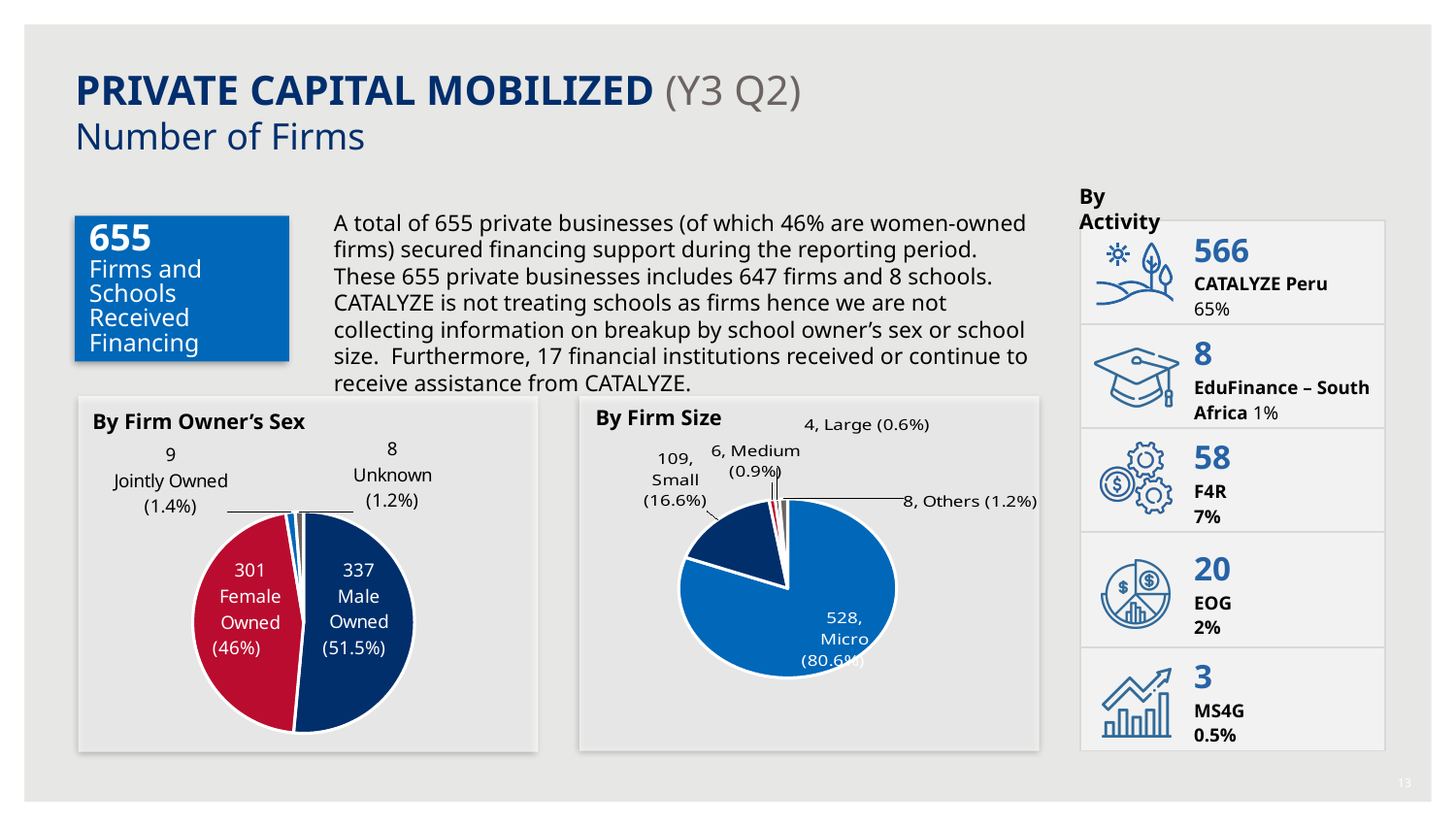
In the 'By Firm Owner's Sex' chart, which category has the smallest number of firms? Unknown In the 'By Firm Owner's Sex' chart, how many firms are Male Owned? 337 In the 'By Firm Size' chart, what is the difference between the number of Micro and Small firms? 419 In the 'By Firm Size' chart, how many firms are Micro? 528 What type of chart is the 'By Firm Owner's Sex' chart? Pie chart In the 'By Firm Size' chart, how many categories are shown? 5 In the 'By Firm Size' chart, what share of firms are Small? 16.6% In the 'By Firm Owner's Sex' chart, what is the difference between the number of Male Owned and Female Owned firms? 36 In the 'By Firm Owner's Sex' chart, how many categories are shown? 4 In the 'By Firm Size' chart, which category has the largest number of firms? Micro In the 'By Firm Size' chart, which is larger: Medium or Large? Medium In the 'By Firm Owner's Sex' chart, what share of firms are Female Owned? 46%